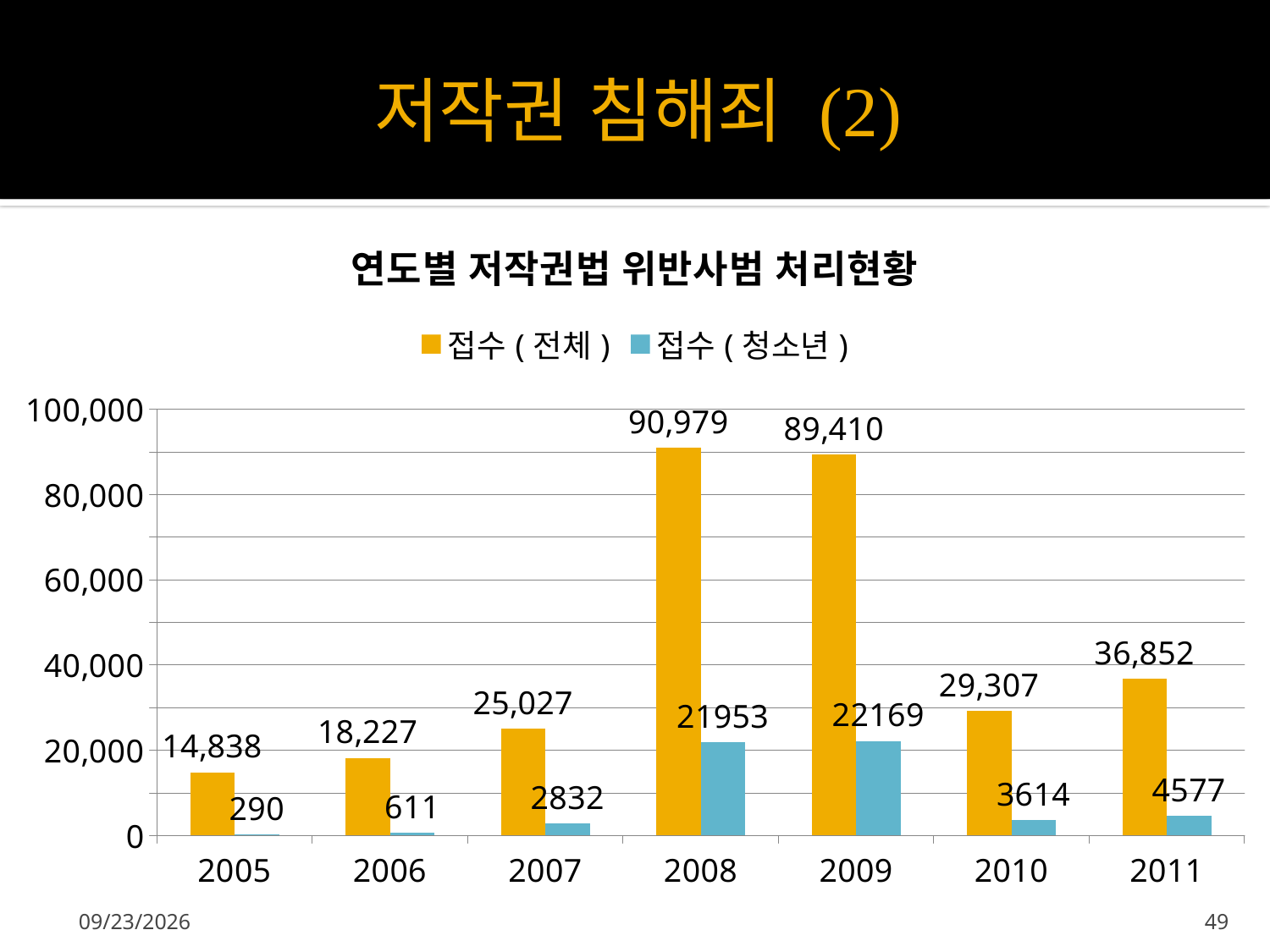
How many series does the legend list? 2 Which year has the highest value for 접수 ( 전체 )? 2008 What is the value of 접수 ( 전체 ) for 2011? 36,852 What type of chart is shown on the slide? Bar chart Is the value of 접수 ( 전체 ) for 2007 greater or less than 20,000? greater Which is larger: 접수 ( 전체 ) in 2010 or in 2011? 2011 Which year has the lowest value for 접수 ( 청소년 )? 2005 What is the value of 접수 ( 전체 ) for 2008? 90,979 What is the difference between 접수 ( 전체 ) in 2008 and 2009? 1,569 What is the value of 접수 ( 청소년 ) for 2009? 22169 How many years are shown on the x axis? 7 What is the value of 접수 ( 청소년 ) for 2005? 290